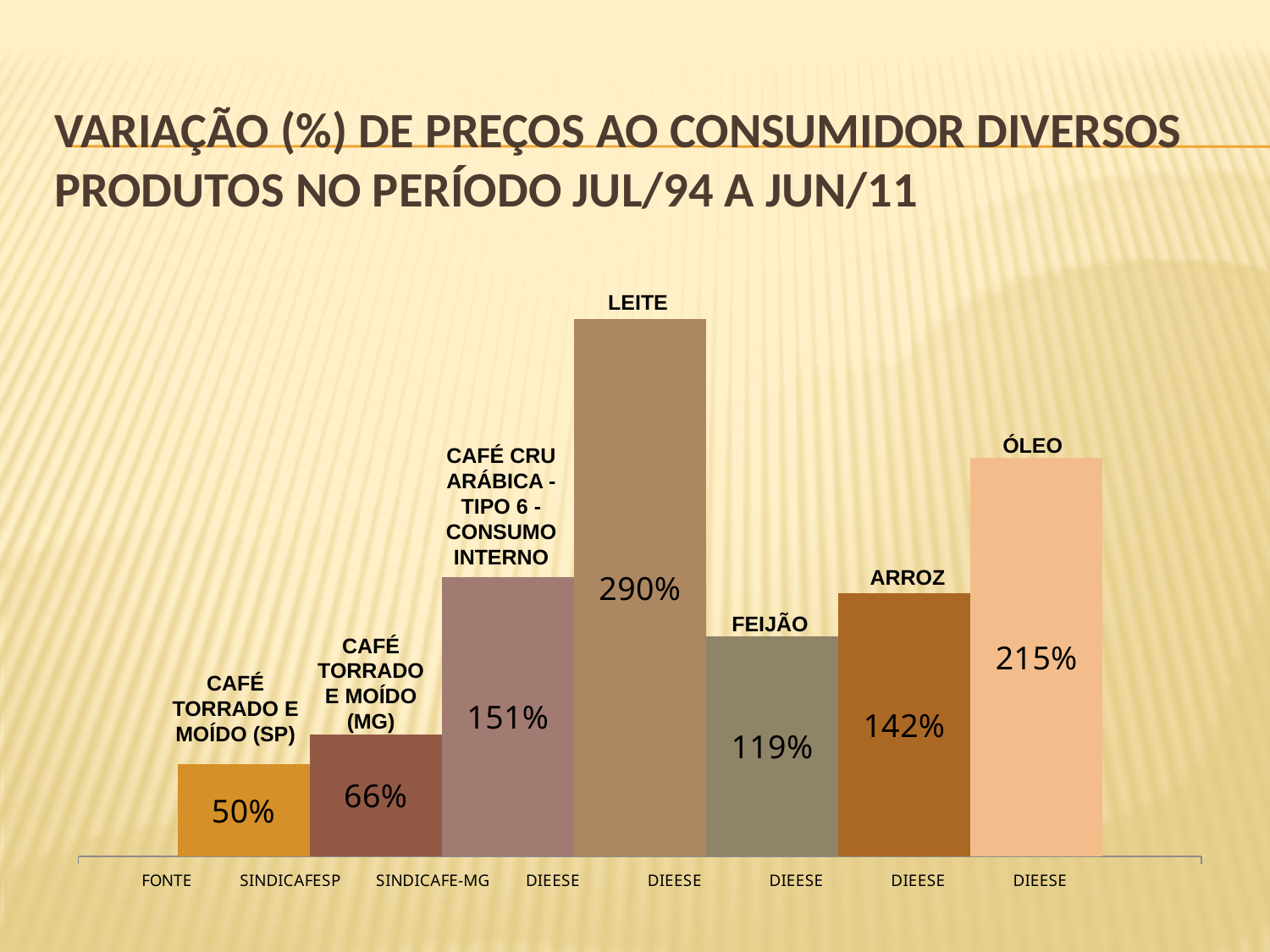
How many products (bars) are shown in the chart? 7 What is the difference between the price variation of ÓLEO and ARROZ? 73% What is the price variation shown for LEITE? 290% Which product has the highest price variation in the chart? LEITE Which product has the lowest price variation in the chart? CAFÉ TORRADO E MOÍDO (SP) Which has a larger price variation, ARROZ or FEIJÃO? ARROZ What type of chart is shown on the slide? Bar chart What is the price variation shown for FEIJÃO? 119% According to the x-axis labels, what is the source (FONTE) for the LEITE bar? DIEESE What is the price variation shown for ÓLEO? 215% What is the price variation shown for CAFÉ TORRADO E MOÍDO (SP)? 50% What is the difference between the price variation of CAFÉ TORRADO E MOÍDO (MG) and CAFÉ TORRADO E MOÍDO (SP)? 16%